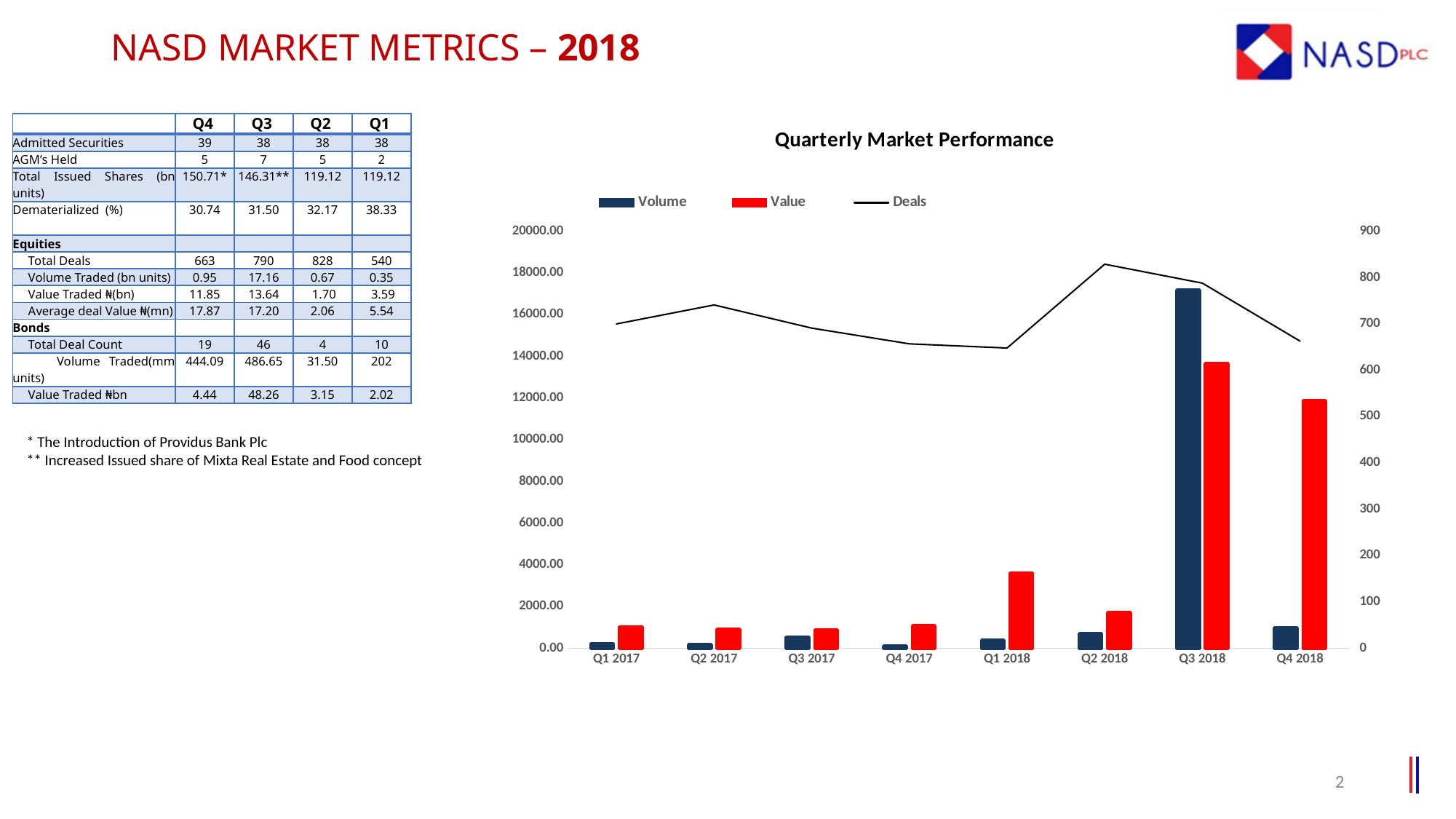
How many series does the legend of the Quarterly Market Performance chart list? 3 How many quarters are shown on the x axis of the Quarterly Market Performance chart? 8 In the Quarterly Market Performance chart, is the Value bar for Q3 2018 greater or less than 12000.00? greater In the Quarterly Market Performance chart, is the Volume bar for Q3 2018 greater or less than 16000.00? greater In the Quarterly Market Performance chart, is the Deals line for Q1 2018 greater or less than 800 on the right axis? less What kind of chart is the Quarterly Market Performance chart? A combination bar and line chart In the Quarterly Market Performance chart, which quarter has the highest Value bar? Q3 2018 In the Quarterly Market Performance chart, which is larger for Q1 2018, the Volume bar or the Value bar? Value In the Quarterly Market Performance chart, which quarter has the highest Volume bar? Q3 2018 In the Quarterly Market Performance chart, which series is shown in red? Value